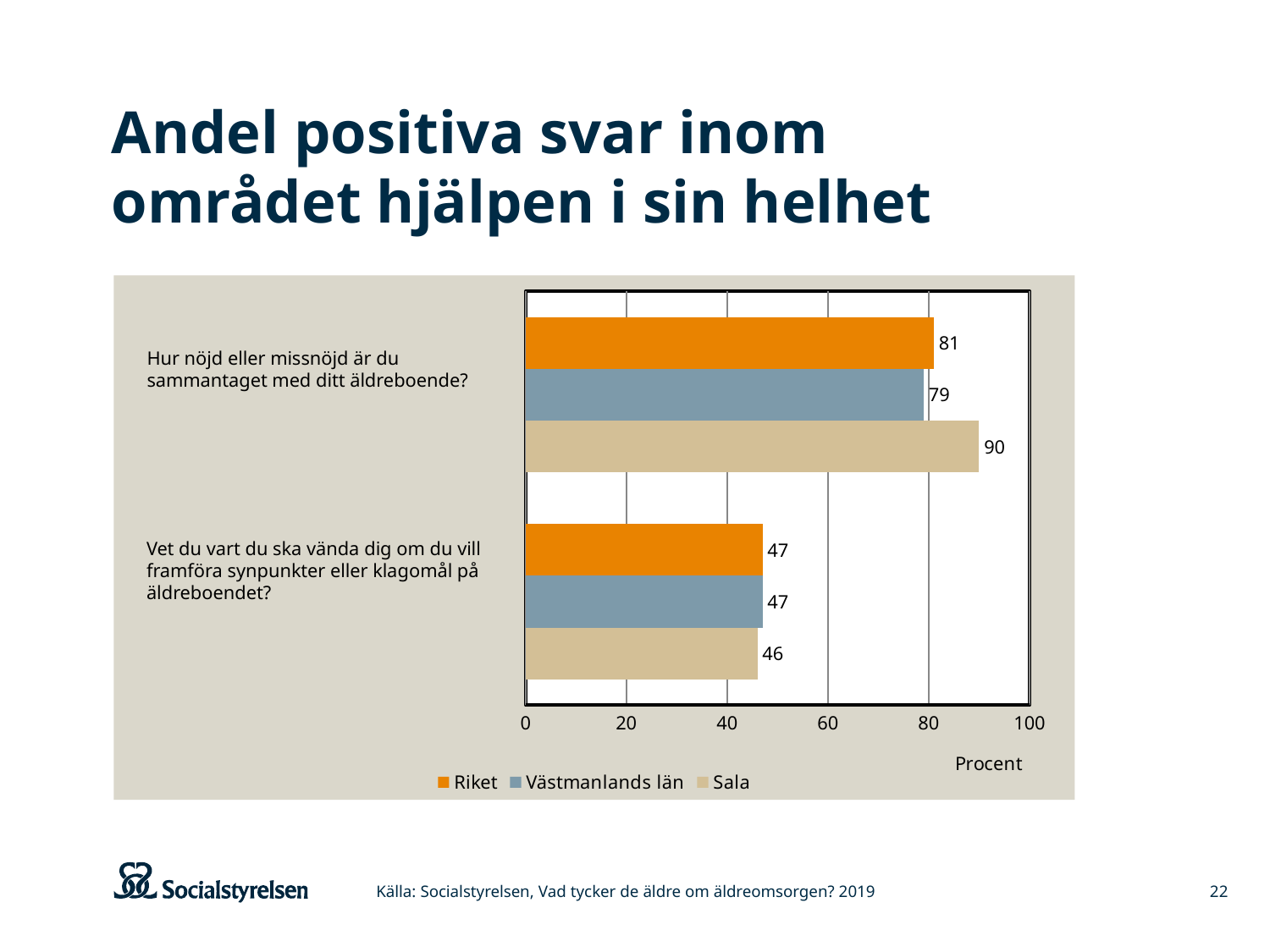
What is the value for Riket on the question 'Hur nöjd eller missnöjd är du sammantaget med ditt äldreboende?' 81 What is the label of the horizontal axis? Procent Which series has the highest value on the question 'Hur nöjd eller missnöjd är du sammantaget med ditt äldreboende?' Sala What kind of chart is shown on the slide? Bar chart How many questions (categories) are shown in the chart? 2 Which is larger on the question 'Hur nöjd eller missnöjd är du sammantaget med ditt äldreboende?': Riket or Västmanlands län? Riket What is the value for Västmanlands län on the question 'Vet du vart du ska vända dig om du vill framföra synpunkter eller klagomål på äldreboendet?' 47 What is the value for Sala on the question 'Hur nöjd eller missnöjd är du sammantaget med ditt äldreboende?' 90 Which series has the lowest value on the question 'Vet du vart du ska vända dig om du vill framföra synpunkter eller klagomål på äldreboendet?' Sala What is the difference between the Sala value and the Riket value on the question 'Hur nöjd eller missnöjd är du sammantaget med ditt äldreboende?' 9 How many series does the legend list? 3 Is the value for Sala on the question 'Vet du vart du ska vända dig om du vill framföra synpunkter eller klagomål på äldreboendet?' greater or less than 60? less